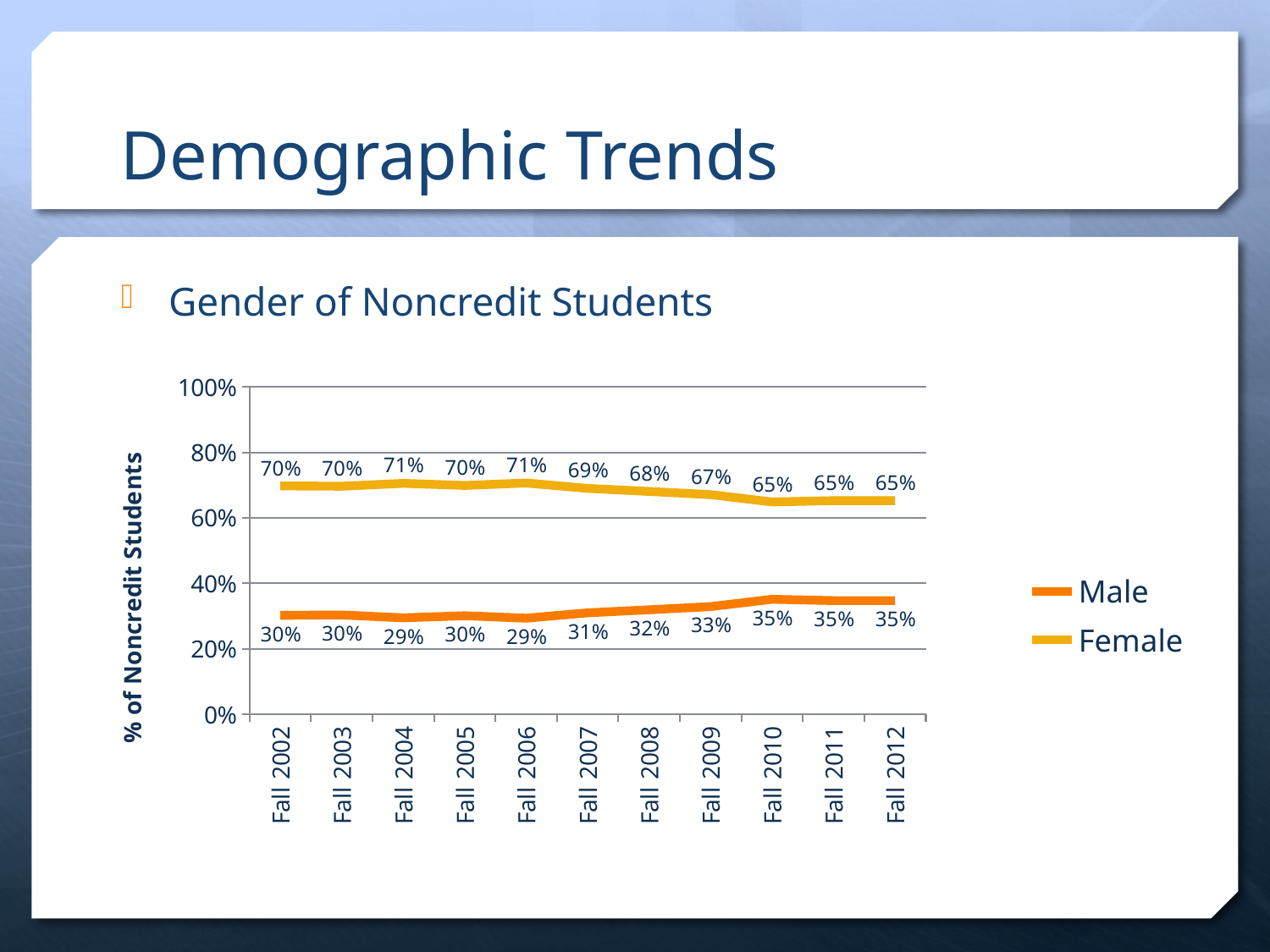
What is the Male value for Fall 2012? 35% How many series does the legend list? 2 What is the Male value for Fall 2007? 31% How many years are shown on the x axis? 11 What kind of chart is shown on the slide? line chart What is the difference between the Female and Male values in Fall 2009? 34% Does the Male series rise or fall from Fall 2002 to Fall 2012? rise What is the highest value shown for the Male series? 35% Which series has the larger value in Fall 2005, Male or Female? Female In which year(s) does the Female series reach its lowest value? Fall 2010, Fall 2011, Fall 2012 What is the Female value for Fall 2002? 70% Is the Female value for Fall 2004 greater or less than 60%? greater